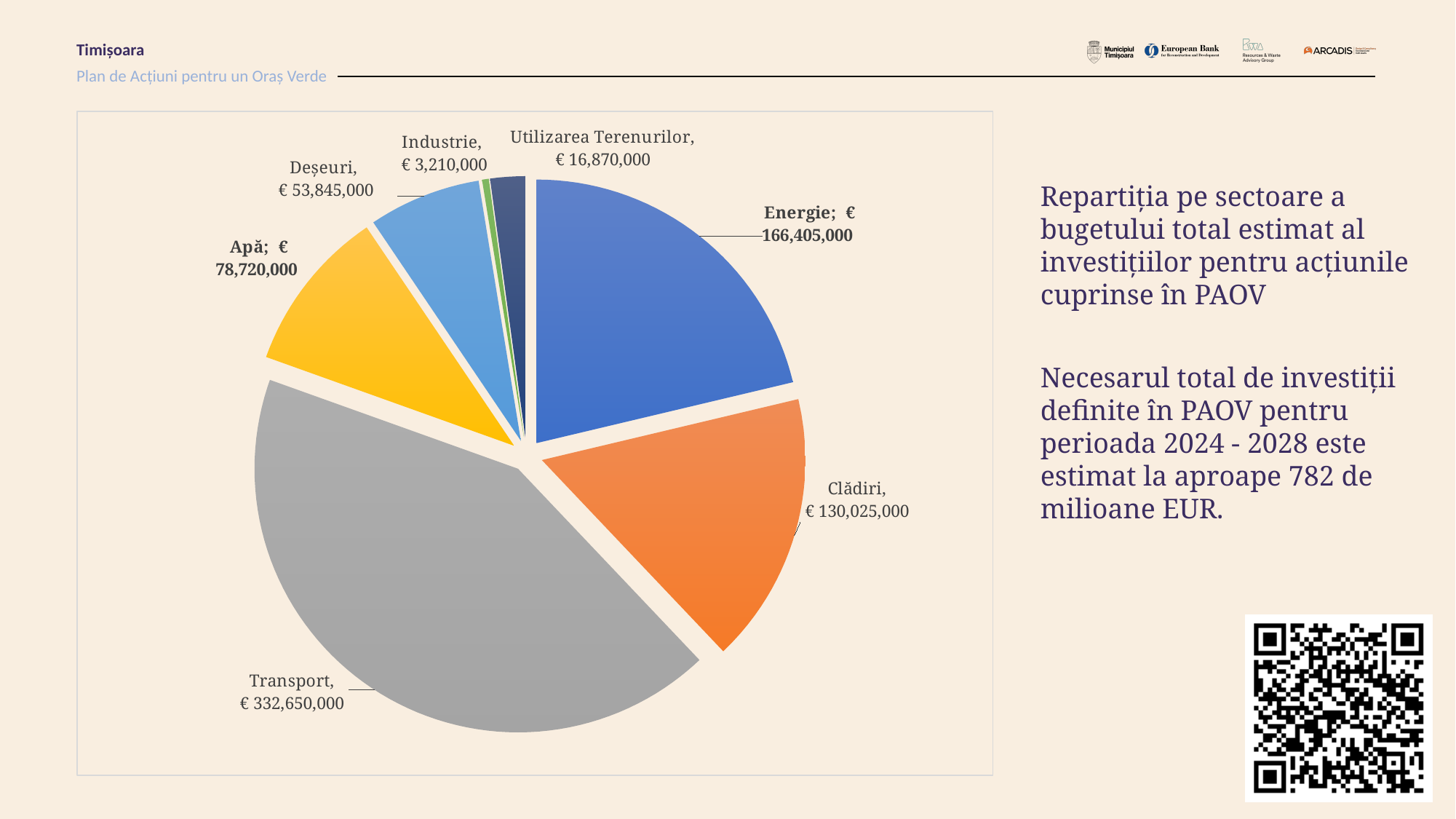
What is the difference between the Apă and Deșeuri values in the pie chart? € 24,875,000 What is the value shown for Transport in the pie chart? € 332,650,000 How many sectors (slices) does the pie chart show? 7 What is the difference between the Transport and Energie values in the pie chart? € 166,245,000 What is the value shown for Industrie in the pie chart? € 3,210,000 Which sector has the largest slice of the pie chart? Transport What is the value shown for Utilizarea Terenurilor in the pie chart? € 16,870,000 What colour is the Transport slice in the pie chart? grey What is the value shown for Energie in the pie chart? € 166,405,000 What kind of chart is shown on the slide? pie chart Which is larger in the pie chart, Clădiri or Apă? Clădiri Which sector has the smallest slice of the pie chart? Industrie